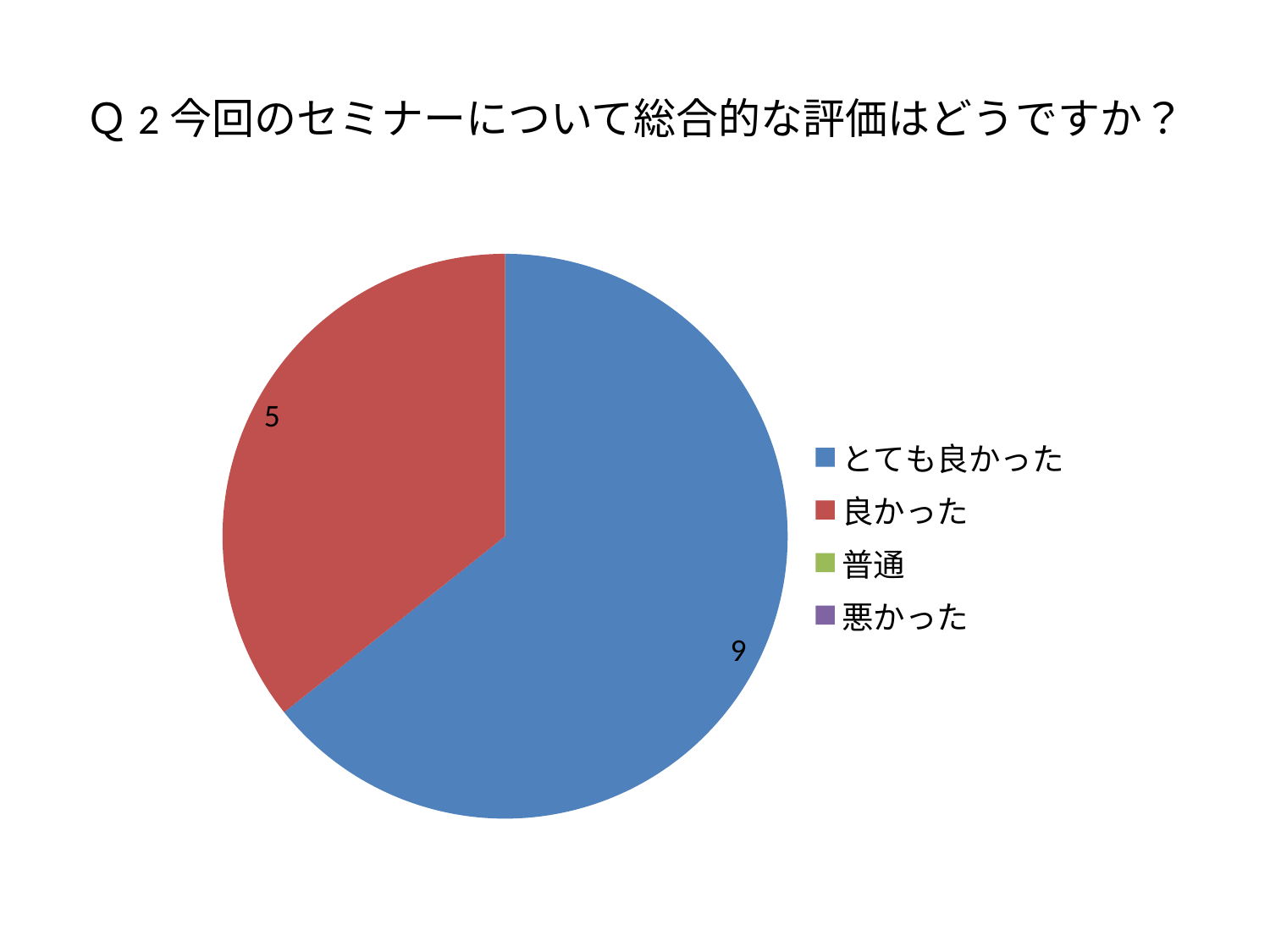
What colour is the slice for とても良かった? blue Which category has the largest slice of the pie? とても良かった How many slices with data labels are visible in the pie? 2 What is the value shown for 良かった? 5 Of the two labelled slices, which category has the smaller value? 良かった What is the title of the chart? Q２今回のセミナーについて総合的な評価はどうですか？ Which is larger, the value for とても良かった or the value for 良かった? とても良かった How many categories does the legend list? 4 What is the total of the two labelled slices in the pie? 14 What is the value shown for とても良かった? 9 What kind of chart is shown on the slide? pie chart What is the difference between the value for とても良かった and the value for 良かった? 4